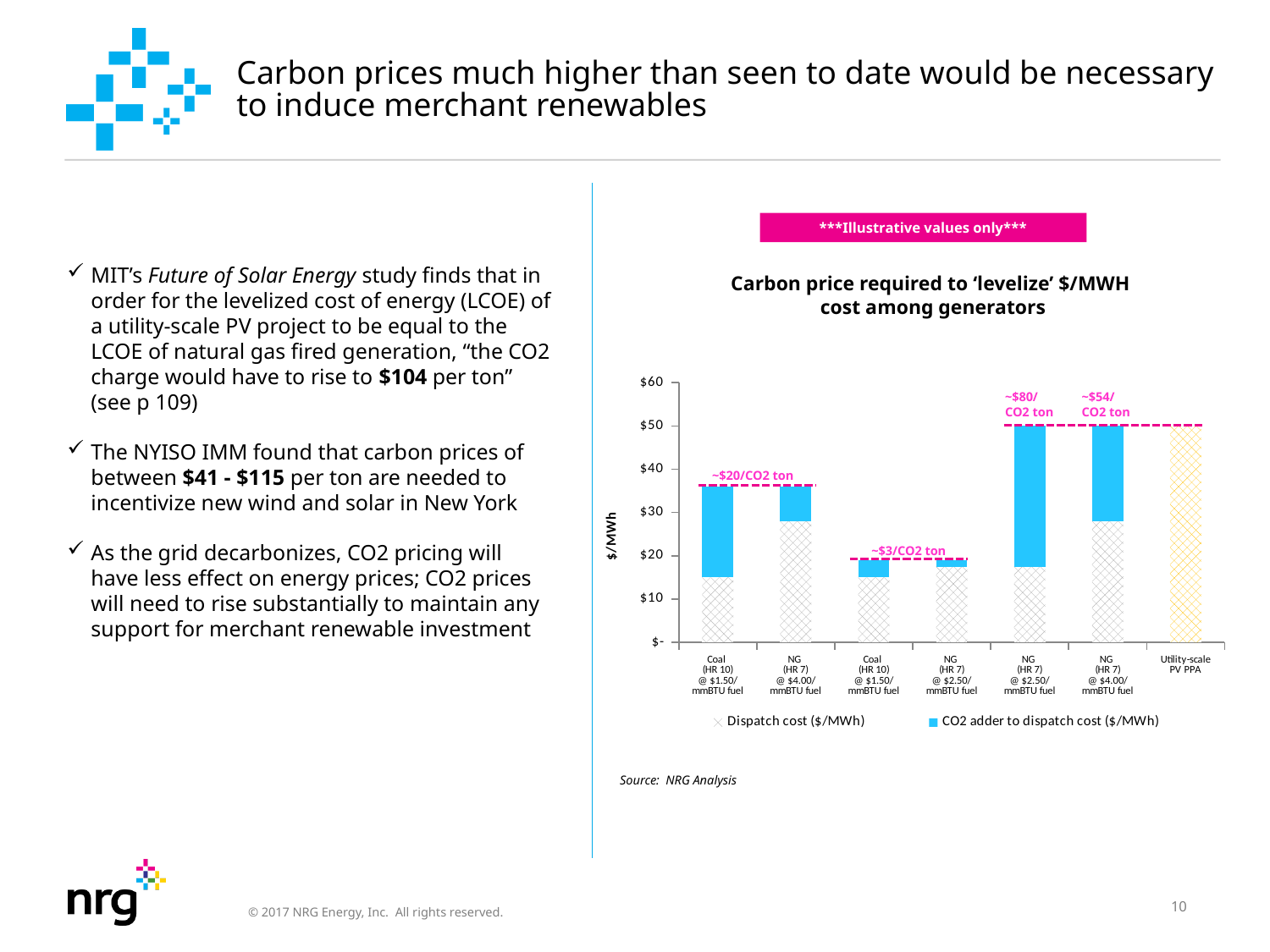
Which has the larger total bar height: the Utility-scale PV PPA bar or the second bar from the left (NG (HR 7) @ $4.00/mmBTU fuel)? Utility-scale PV PPA How many series does the chart's legend list? 2 How many bars (categories) are plotted along the x axis of the chart? 7 What are the two series named in the chart's legend? Dispatch cost ($/MWh) and CO2 adder to dispatch cost ($/MWh) Is the total height of the Utility-scale PV PPA bar greater or less than $40? greater Is the dispatch cost portion of the leftmost Coal bar greater or less than $20? less What is the title of the chart? Carbon price required to 'levelize' $/MWh cost among generators Is the dispatch cost portion of the second bar from the left (NG (HR 7) @ $4.00/mmBTU fuel) greater or less than $20? greater Which has the larger total bar height: the leftmost Coal bar or the third bar from the left (the second Coal bar)? The leftmost Coal bar What kind of chart is shown on the slide? Stacked bar chart